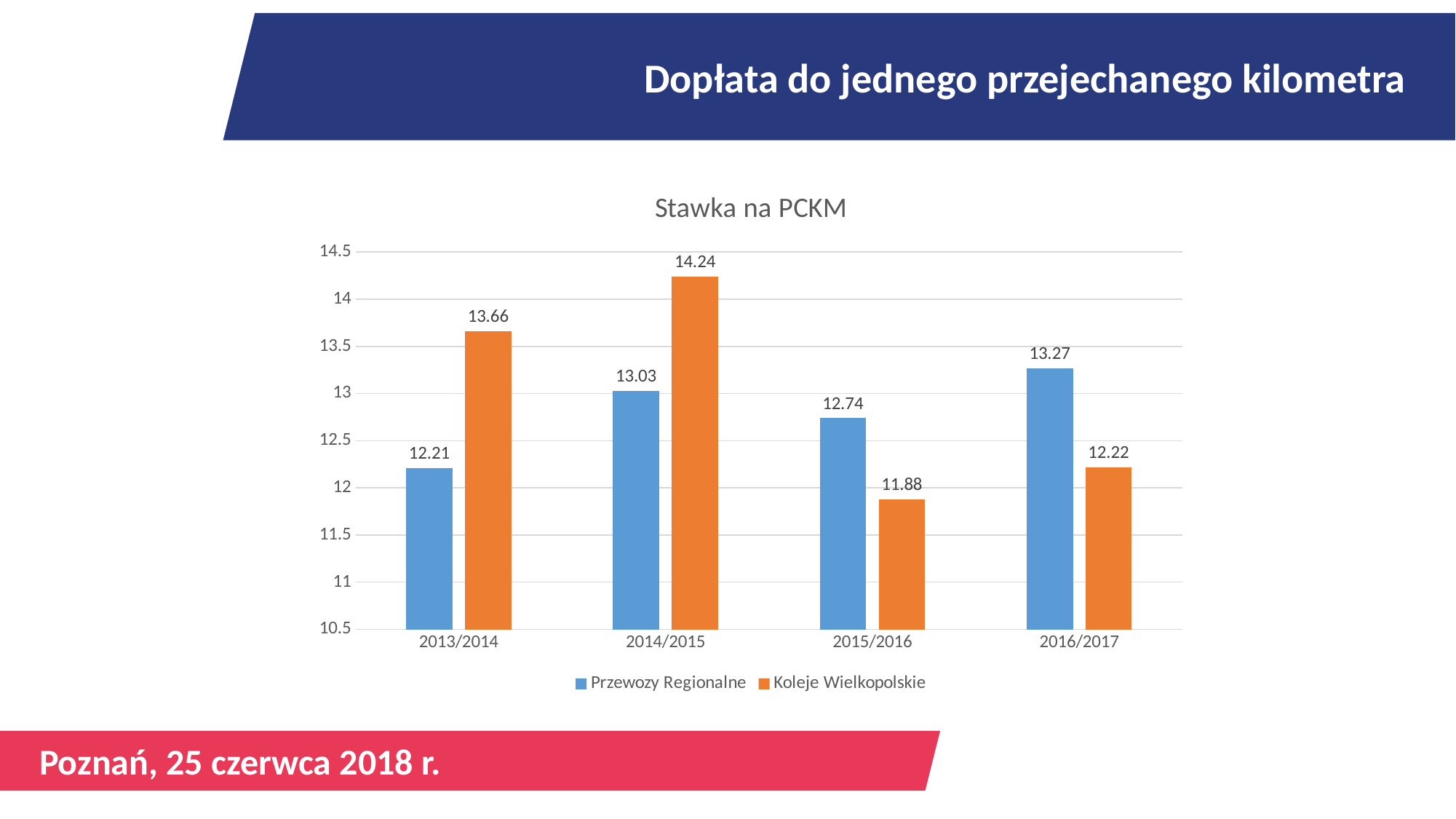
Which series has the larger value in 2016/2017? Przewozy Regionalne What is the value for Koleje Wielkopolskie in 2014/2015? 14.24 In which year does Przewozy Regionalne have its highest value? 2016/2017 What kind of chart is shown? bar chart What is the difference between Koleje Wielkopolskie and Przewozy Regionalne in 2013/2014? 1.45 What is the value for Koleje Wielkopolskie in 2015/2016? 11.88 How many year categories are shown on the x axis? 4 What is the title of the chart? Stawka na PCKM What is the value for Przewozy Regionalne in 2013/2014? 12.21 In which year does Koleje Wielkopolskie have its lowest value? 2015/2016 How many series does the legend list? 2 Is the value for Koleje Wielkopolskie in 2014/2015 greater or less than 14? greater